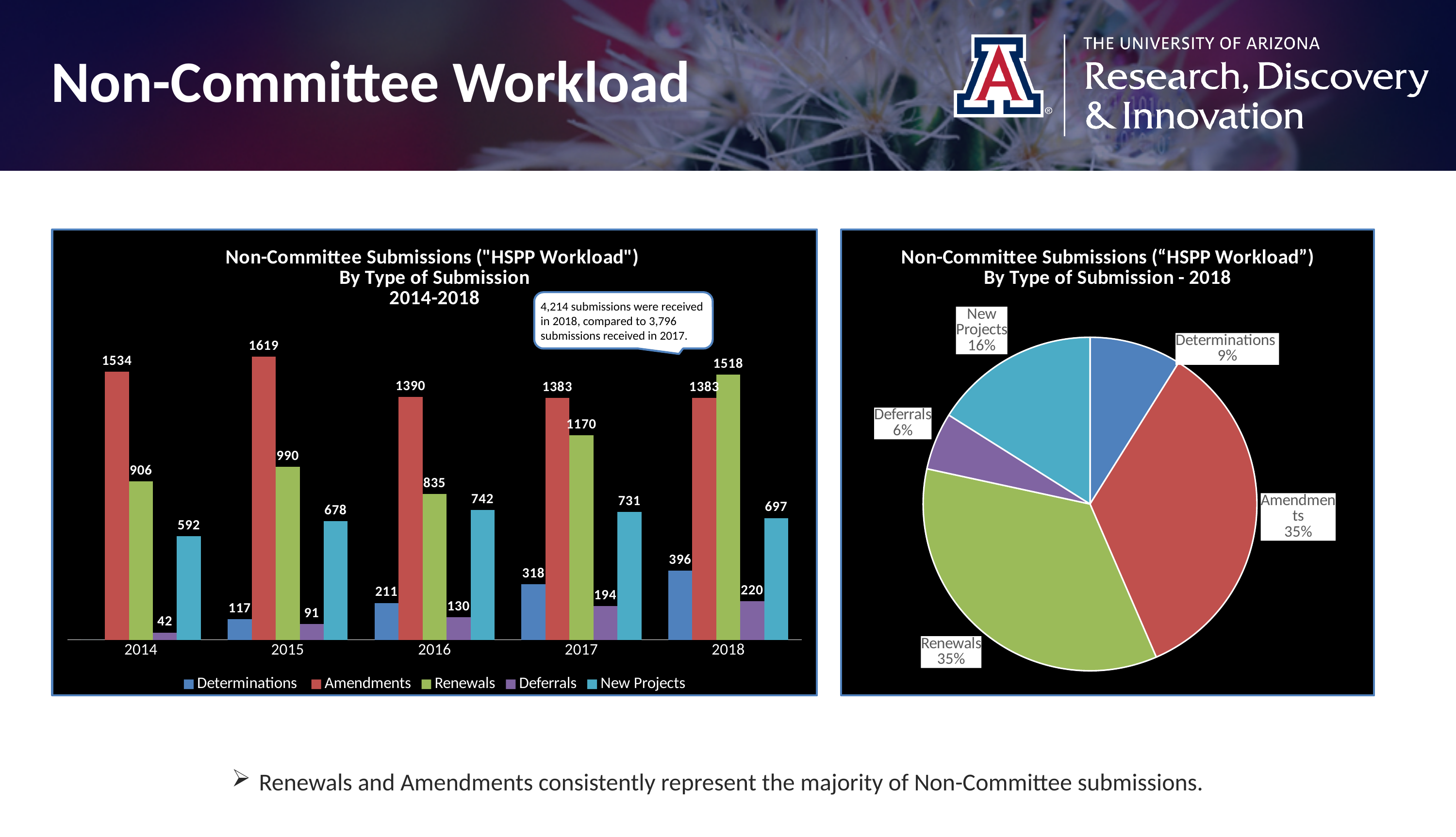
In the left bar chart (2014-2018), what is the value for Deferrals in 2014? 42 In the right pie chart (2018), what share of submissions is New Projects? 16% In the left bar chart (2014-2018), what is the difference between New Projects in 2016 and New Projects in 2014? 150 What kind of chart is the chart on the right of the slide? pie chart In the left bar chart (2014-2018), which is larger in 2018: Amendments or Renewals? Renewals In the left bar chart (2014-2018), which year has the highest Amendments value? 2015 In the right pie chart (2018), which category has the smallest share? Deferrals In the left bar chart (2014-2018), what is the value for Renewals in 2018? 1518 In the left bar chart (2014-2018), do the Determinations values rise or fall from 2014 to 2018? rise In the left bar chart (2014-2018), how many series does the legend list? 5 In the left bar chart (2014-2018), what is the value for Amendments in 2015? 1619